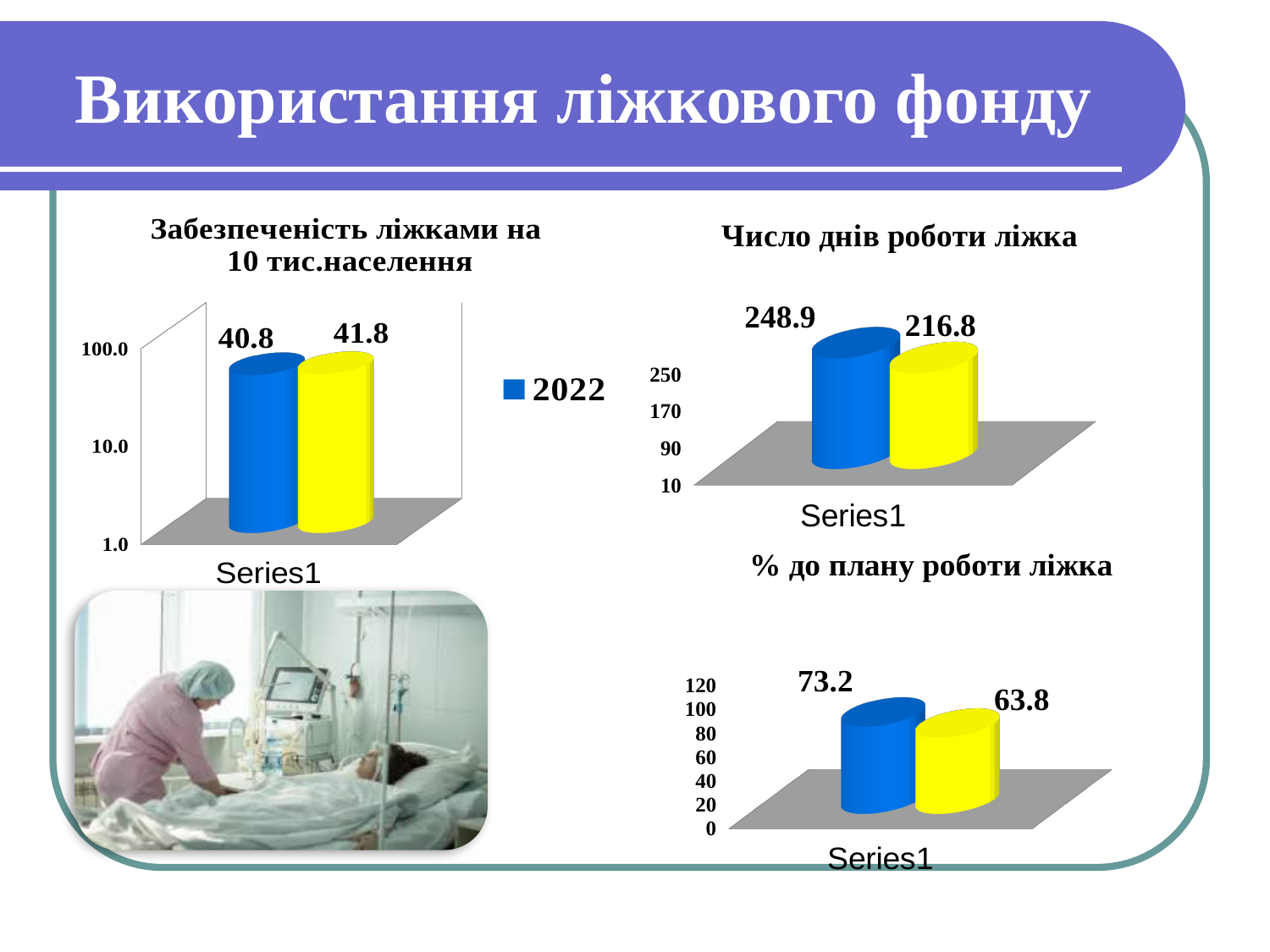
In the chart titled "Забезпеченість ліжками на 10 тис.населення", what is the value of the blue bar? 40.8 In the chart titled "Число днів роботи ліжка", which bar is higher, the blue one or the yellow one? the blue one What kind of chart is the one titled "% до плану роботи ліжка"? bar chart In the chart titled "Забезпеченість ліжками на 10 тис.населення", what is the value of the yellow bar? 41.8 In the chart titled "Забезпеченість ліжками на 10 тис.населення", what is the difference between the yellow bar and the blue bar? 1.0 In the chart titled "% до плану роботи ліжка", what is the value of the blue bar? 73.2 In the chart titled "Число днів роботи ліжка", what is the value of the blue bar? 248.9 In the chart titled "Забезпеченість ліжками на 10 тис.населення", what entry does the legend show? 2022 In the chart titled "% до плану роботи ліжка", what is the difference between the blue bar and the yellow bar? 9.4 In the chart titled "Число днів роботи ліжка", what is the value of the yellow bar? 216.8 In the chart titled "Число днів роботи ліжка", what is the difference between the blue bar and the yellow bar? 32.1 In the chart titled "% до плану роботи ліжка", what is the value of the yellow bar? 63.8